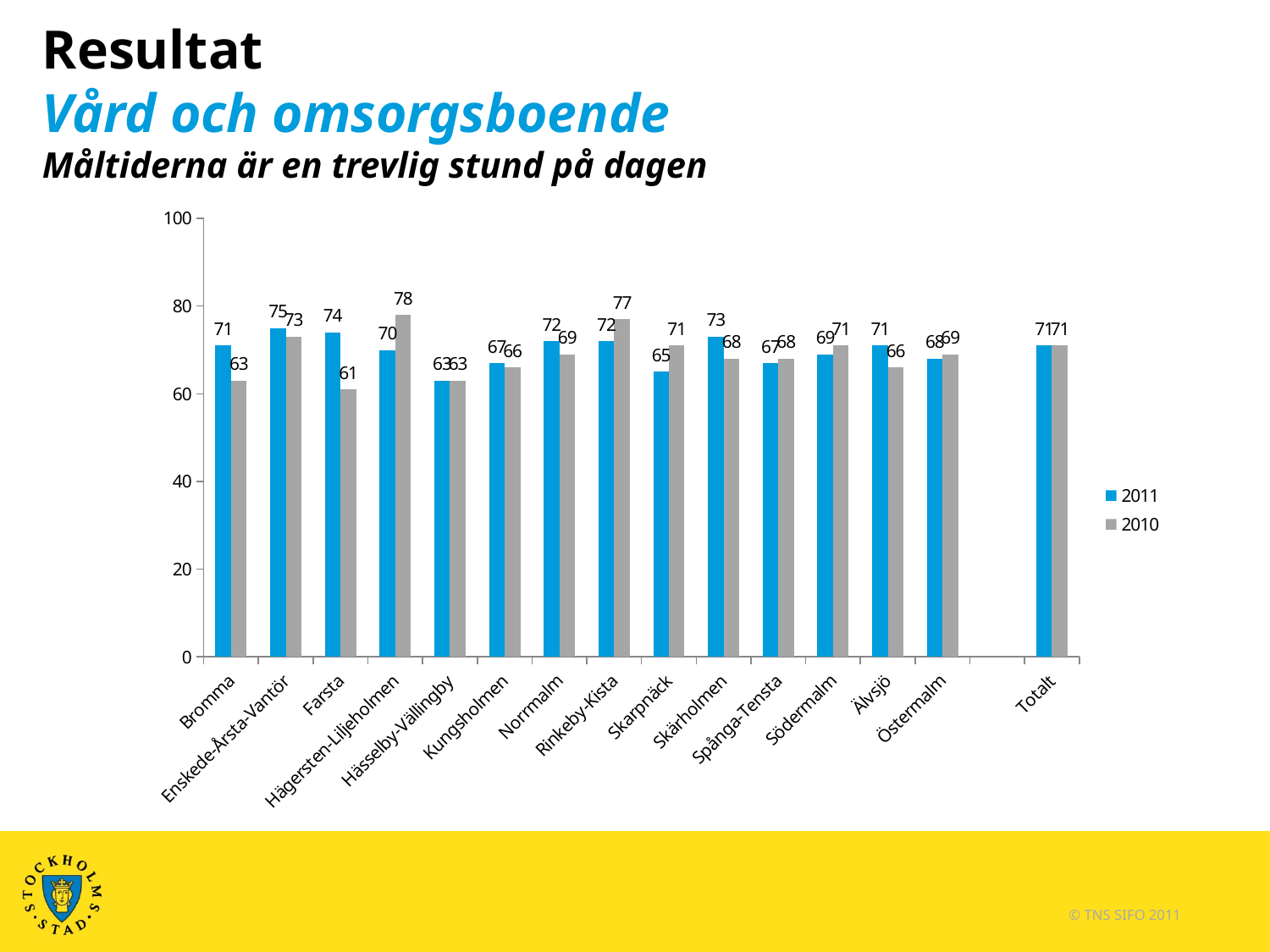
What kind of chart is shown on the slide? Bar chart What is the 2011 value for Totalt? 71 Which category has the highest 2011 value? Enskede-Årsta-Vantör Which category has the lowest 2010 value? Farsta For Skarpnäck, which is larger: the 2011 value or the 2010 value? 2010 How many categories are shown on the x axis? 15 What is the 2010 value for Farsta? 61 What is the difference between the 2011 and 2010 values for Farsta? 13 What is the difference between the 2010 and 2011 values for Hägersten-Liljeholmen? 8 How many series does the legend list? 2 Which category has the highest 2010 value? Hägersten-Liljeholmen What is the 2011 value for Bromma? 71